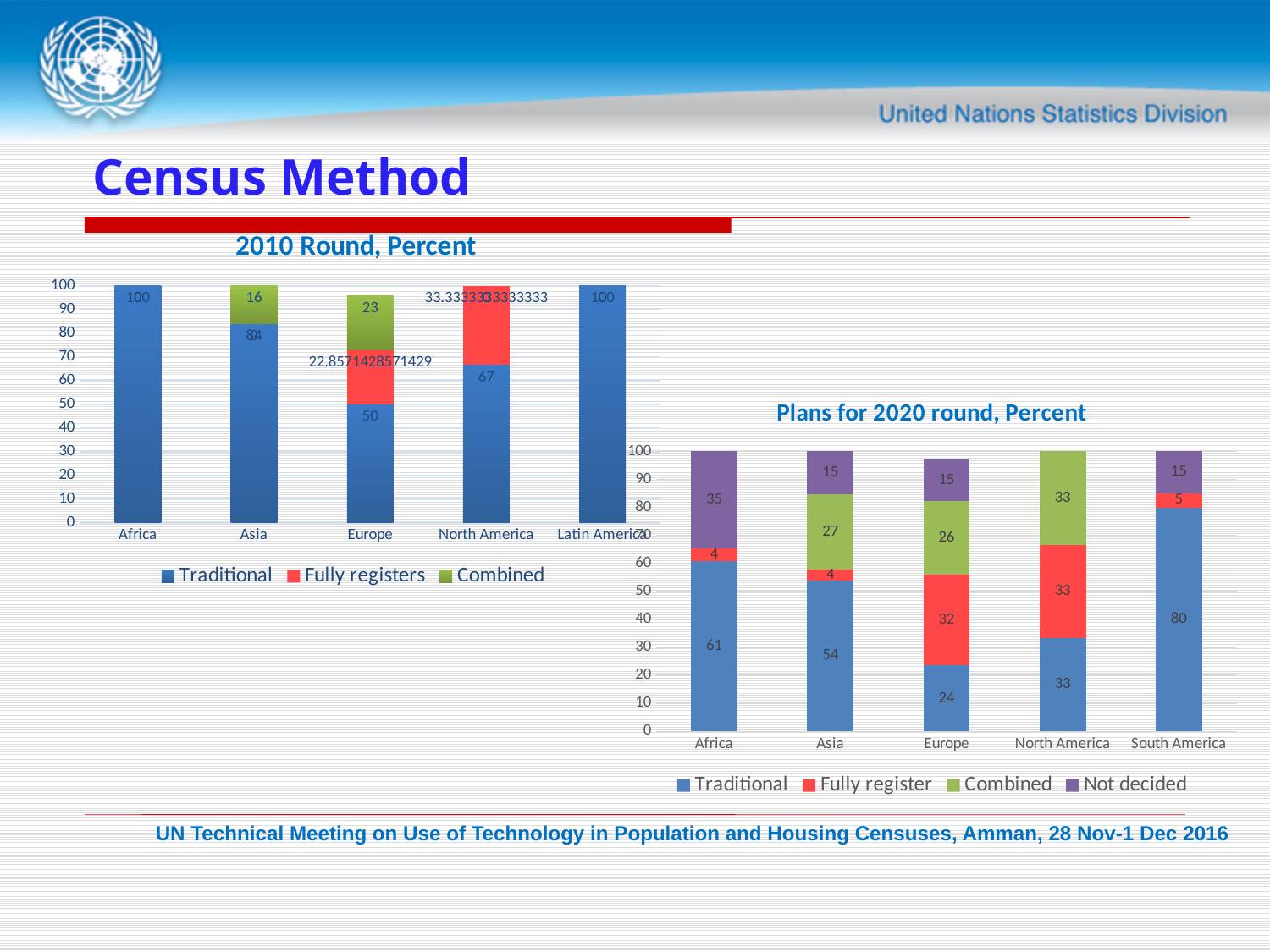
In the 'Plans for 2020 round, Percent' chart, is the Fully register value for Europe larger than the Fully register value for Asia? Yes, Europe In the '2010 Round, Percent' chart, what is the Traditional value for North America? 67 In the 'Plans for 2020 round, Percent' chart, what is the Traditional value for Europe? 24 How many regions are shown on the x axis of the '2010 Round, Percent' chart? 5 In the 'Plans for 2020 round, Percent' chart, what is the Not decided value for Africa? 35 In the 'Plans for 2020 round, Percent' chart, what is the Combined value for North America? 33 What kind of chart is the '2010 Round, Percent' chart? Stacked bar chart In the 'Plans for 2020 round, Percent' chart, which region has the highest Traditional value? South America In the '2010 Round, Percent' chart, what is the Traditional value for Africa? 100 In the 'Plans for 2020 round, Percent' chart, what is the difference between the Traditional values for South America and Asia? 26 In the 'Plans for 2020 round, Percent' chart, which region has the lowest Traditional value? Europe How many series does the legend of the 'Plans for 2020 round, Percent' chart list? 4